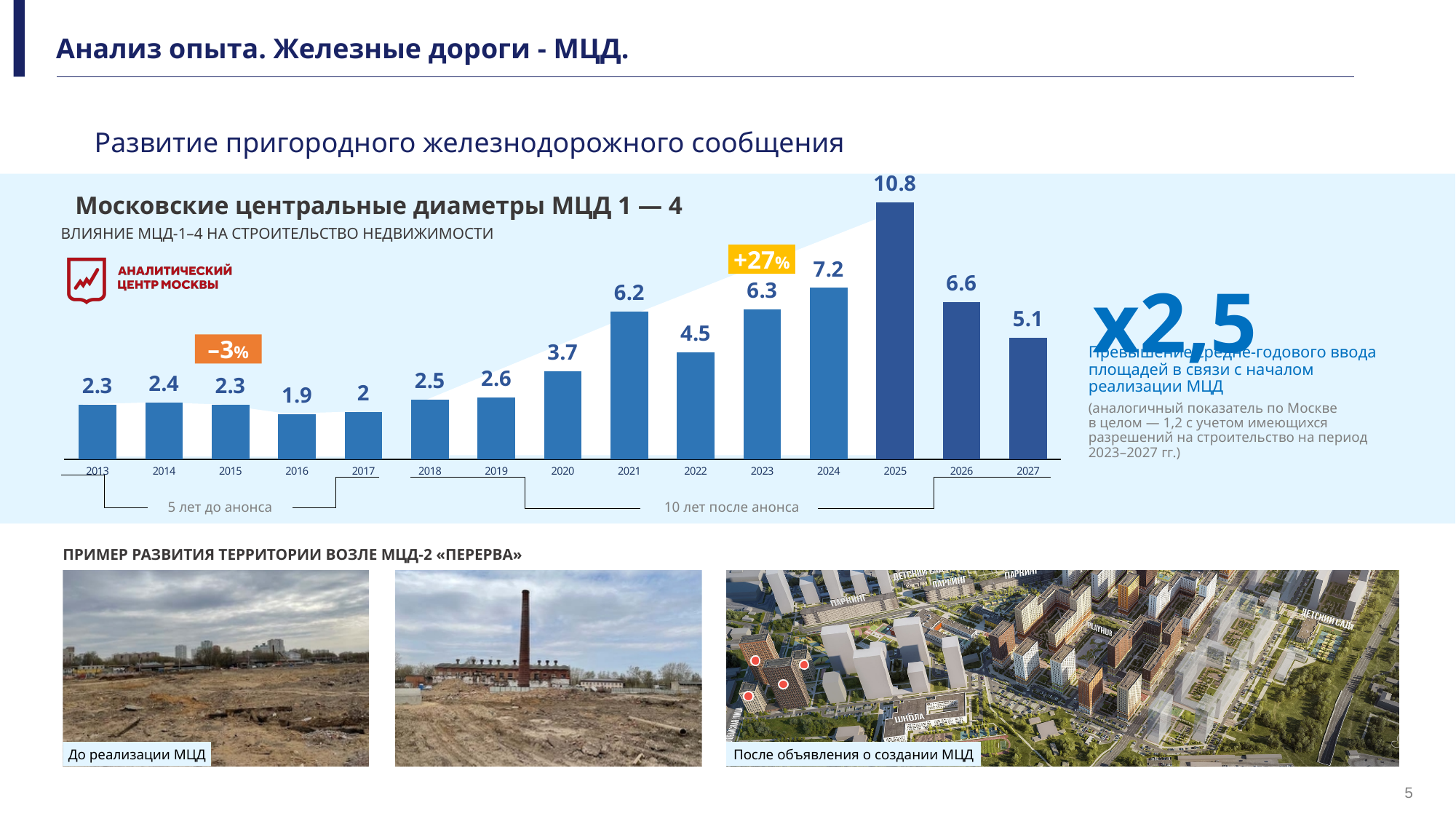
Do the values rise or fall from 2025 to 2027? fall What is the value shown for 2021 in the chart? 6.2 What is the title of the chart? Московские центральные диаметры МЦД 1 — 4 Which year has the lowest value in the chart? 2016 What is the difference between the values for 2022 and 2020? 0.8 What is the value shown for 2025 in the chart? 10.8 What is the difference between the values for 2025 and 2024? 3.6 Which is larger, the value for 2023 or the value for 2026? 2026 How many years (bars) are shown in the chart? 15 What is the value shown for 2016 in the chart? 1.9 Which year has the highest value in the chart? 2025 What type of chart is shown on the slide? bar chart